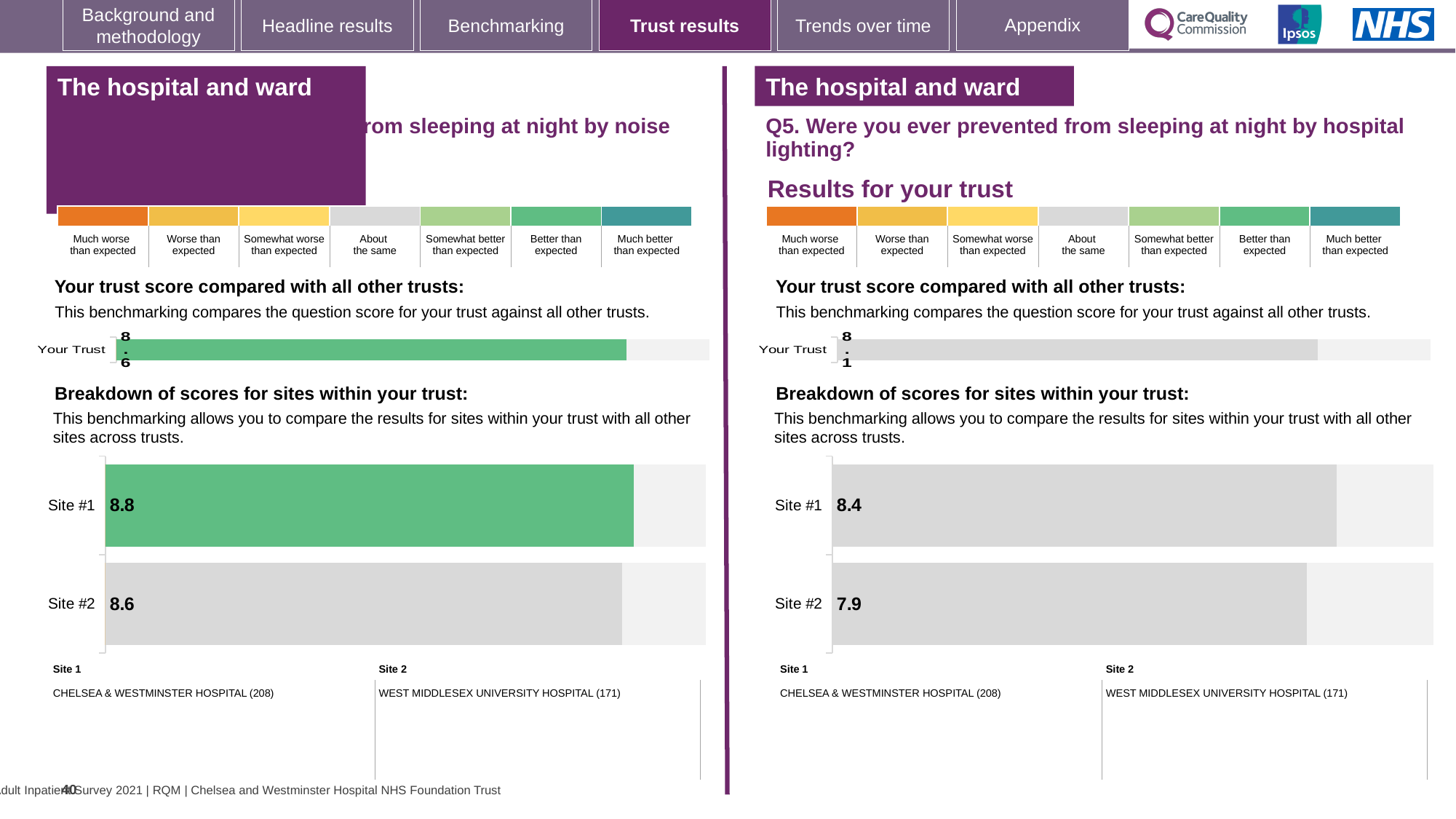
On the right-hand side (Q5, hospital lighting), what is the difference between the Site #1 and Site #2 scores in the site breakdown chart? 0.5 On the left-hand side (sleeping at night by noise), what is the difference between the Site #1 and Site #2 scores in the site breakdown chart? 0.2 How many sites are shown in the right-hand breakdown of scores for sites within your trust chart? 2 On the right-hand side (Q5, hospital lighting), what is the score shown for Your Trust in the trust score chart? 8.1 On the left-hand side (sleeping at night by noise), what is the score shown for Your Trust in the trust score chart? 8.6 What type of chart is used for the breakdown of scores for sites within your trust on the right-hand side? Bar chart On the left-hand side (sleeping at night by noise), which site has the lower score in the breakdown of scores for sites within your trust? Site #2 On the right-hand side (Q5, hospital lighting), what is the score shown for Site #1 in the breakdown of scores for sites within your trust? 8.4 On the left-hand side (sleeping at night by noise), what is the score shown for Site #1 in the breakdown of scores for sites within your trust? 8.8 On the right-hand side (Q5, hospital lighting), what is the score shown for Site #2 in the breakdown of scores for sites within your trust? 7.9 On the left-hand side (sleeping at night by noise), what is the score shown for Site #2 in the breakdown of scores for sites within your trust? 8.6 On the right-hand side (Q5, hospital lighting), which site has the higher score in the breakdown of scores for sites within your trust? Site #1